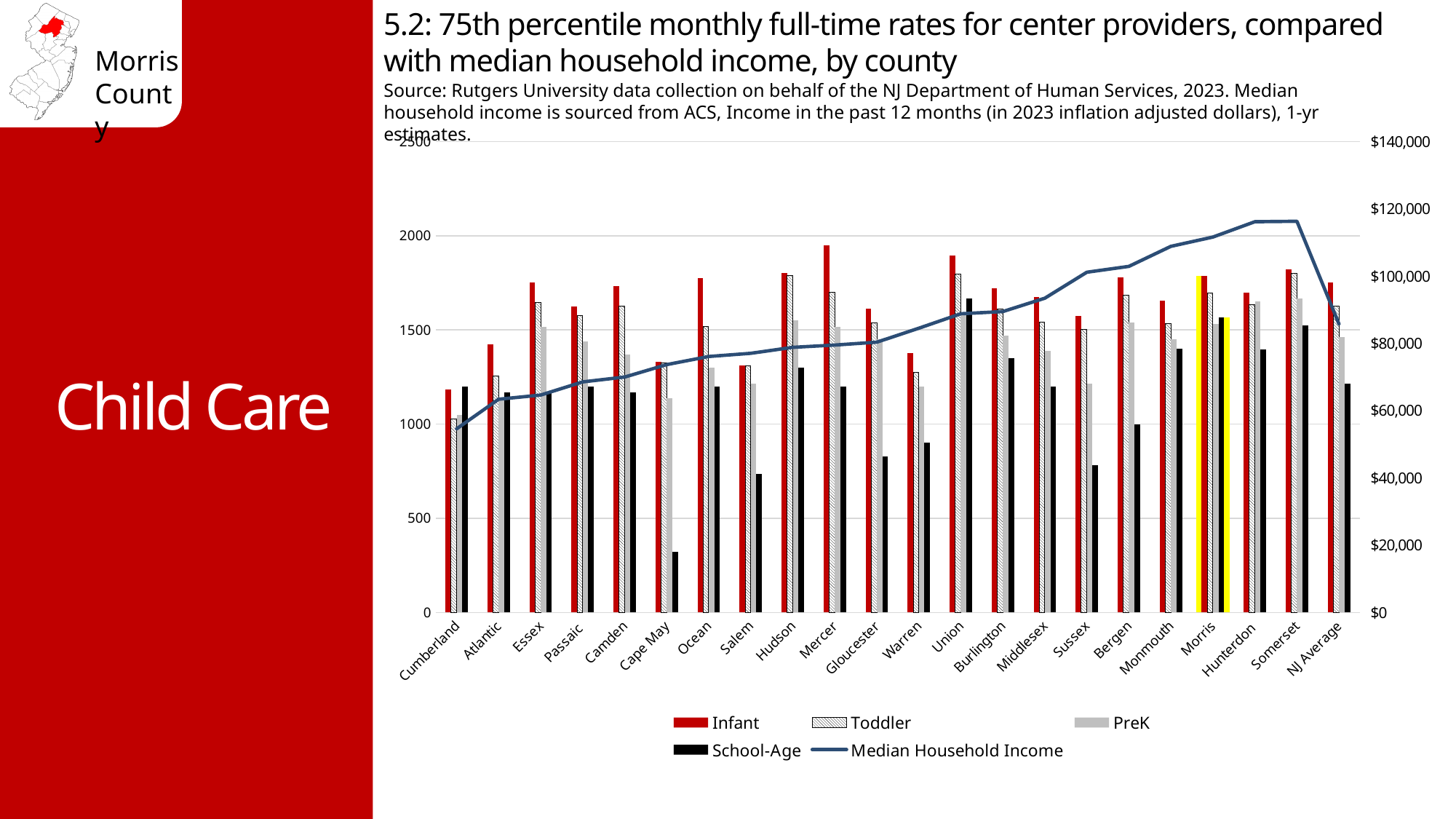
Is the Infant rate for Cumberland greater or less than 1000? greater Is the Median Household Income for Somerset greater or less than $100,000? greater Which county's bars are highlighted in yellow? Morris Does the Median Household Income line generally rise or fall from Cumberland to Somerset? rise How many series does the legend list? 5 What kind of chart is shown on the slide? A bar chart with a line Which county has the lowest School-Age rate? Cape May How many categories are shown along the x axis? 22 Which county has the highest Infant rate? Mercer Which is larger, the School-Age rate for Union or for Bergen? Union Is the School-Age rate for Cape May greater or less than 500? less Which county has the lowest Infant rate? Cumberland